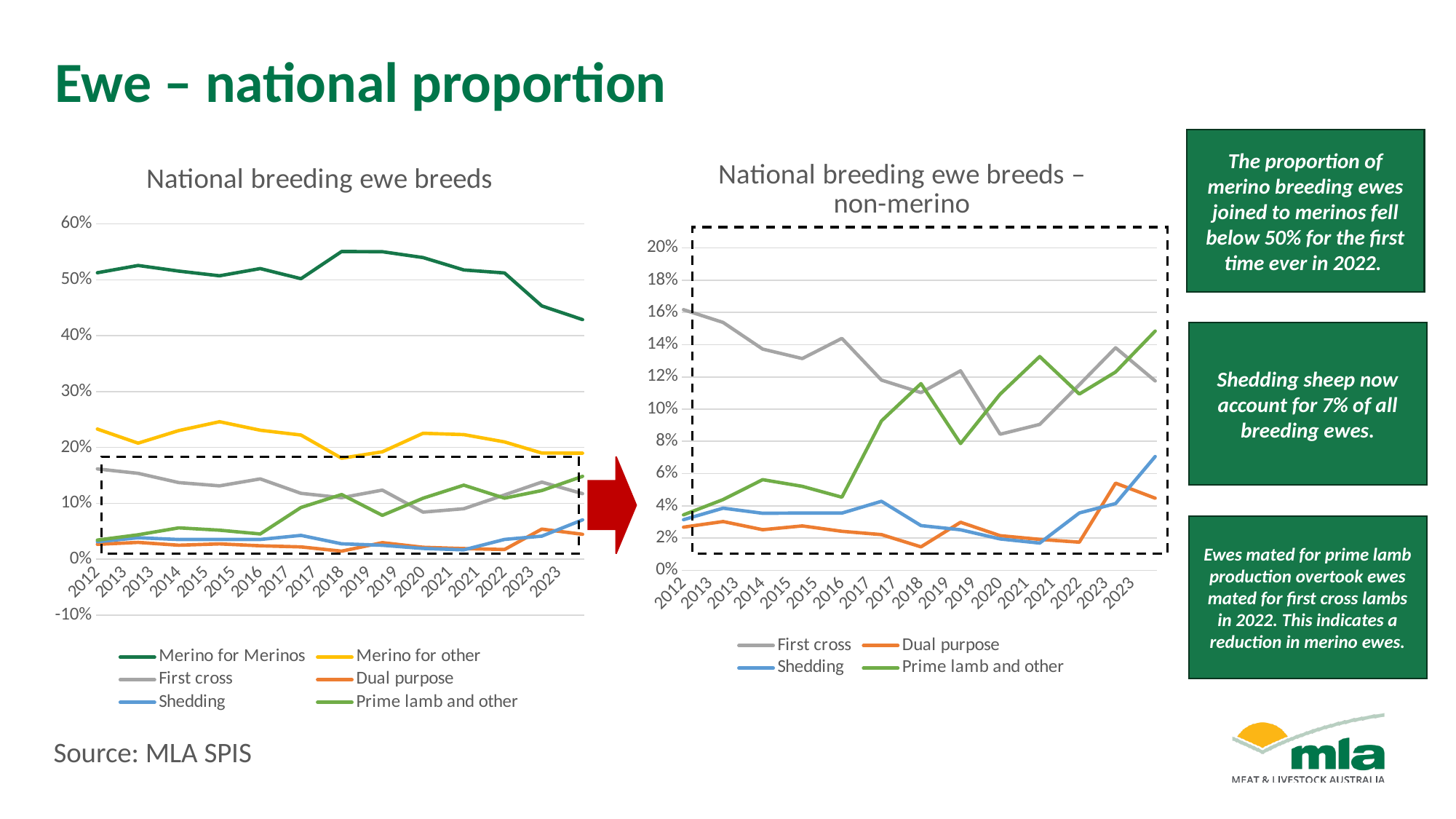
In the right chart, 'National breeding ewe breeds – non-merino', which series has the highest value at the last 2023 point? Prime lamb and other In the left chart, 'National breeding ewe breeds', which series has the highest values across the whole period? Merino for Merinos In the left chart, 'National breeding ewe breeds', is the value for Merino for Merinos at the last 2023 point greater or less than 50%? less How many series does the legend of the left chart, 'National breeding ewe breeds', list? 6 In the right chart, 'National breeding ewe breeds – non-merino', which series has the lowest value in 2018? Dual purpose In the left chart, 'National breeding ewe breeds', does the Merino for Merinos line rise or fall overall from 2012 to the last 2023 point? Fall What type of chart is the 'National breeding ewe breeds' chart on the left? Line chart In the right chart, 'National breeding ewe breeds – non-merino', is the value for First cross in 2012 greater or less than 14%? greater How many series does the legend of the right chart, 'National breeding ewe breeds – non-merino', list? 4 In the left chart, 'National breeding ewe breeds', is the value for Merino for Merinos in 2018 greater or less than 50%? greater